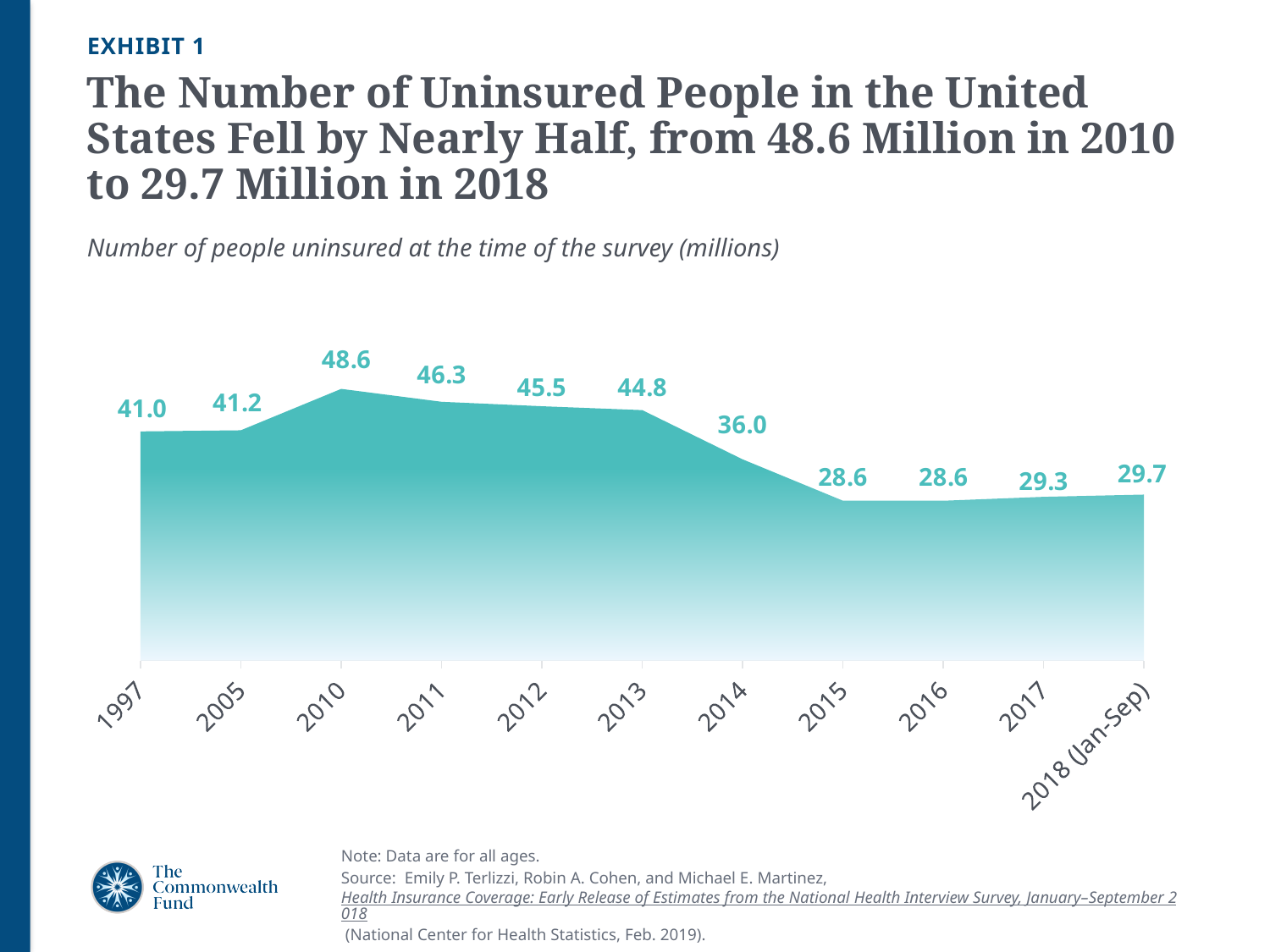
What is the difference in millions between the 2010 value and the 2018 (Jan-Sep) value? 18.9 What is the exhibit number shown on the slide? Exhibit 1 What was the number of uninsured people (in millions) in 2015? 28.6 Which is larger, the value for 2005 or the value for 2017? 2005 What is the difference in millions between the 2013 value and the 2014 value? 8.8 How many data points are plotted on the chart? 11 What was the number of uninsured people (in millions) in 1997? 41.0 What was the number of uninsured people (in millions) in 2010? 48.6 Which years had the lowest number of uninsured people? 2015 and 2016 Which year had the highest number of uninsured people? 2010 What type of chart is shown on the slide? Area chart Do the values generally rise or fall from 2010 to 2016? Fall